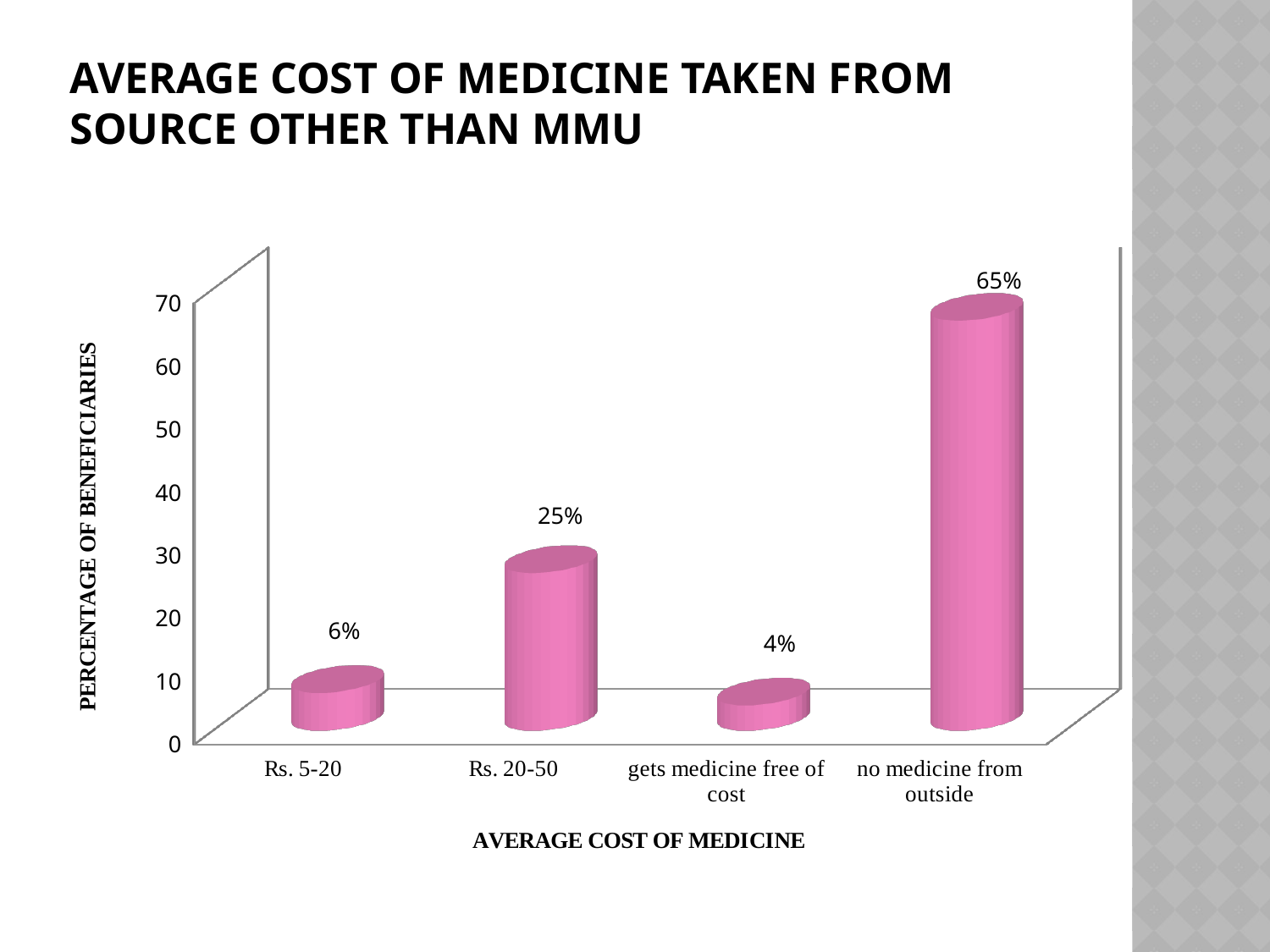
What is the label of the vertical axis? PERCENTAGE OF BENEFICIARIES What percentage of beneficiaries fall in the Rs. 5-20 category? 6% What kind of chart is shown on the slide? bar chart What percentage of beneficiaries get medicine free of cost? 4% How many categories are shown on the x axis? 4 Which category has the highest percentage of beneficiaries? no medicine from outside Which category has the lowest percentage of beneficiaries? gets medicine free of cost What is the difference in percentage points between the 'no medicine from outside' and 'Rs. 20-50' categories? 40 What percentage of beneficiaries take no medicine from outside? 65% Is the value for 'no medicine from outside' greater or less than 60? greater What percentage of beneficiaries fall in the Rs. 20-50 category? 25% Which is larger: the value for Rs. 5-20 or the value for Rs. 20-50? Rs. 20-50